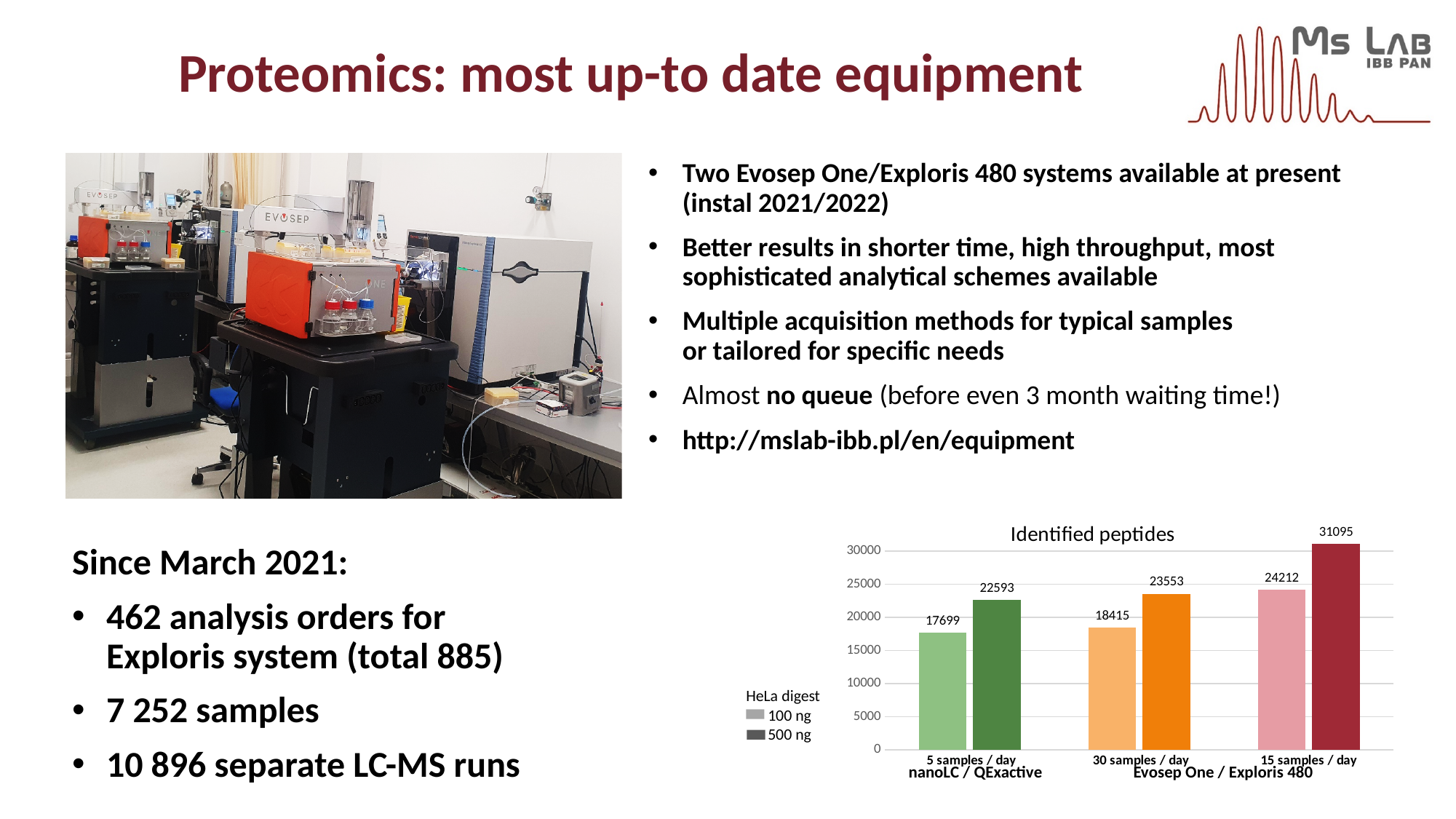
How many series does the chart legend list? 2 What type of chart is shown on the slide? bar chart How many identified peptides are shown for 500 ng at 15 samples / day? 31095 How many categories are shown on the x axis of the chart? 3 How many identified peptides are shown for 500 ng at 30 samples / day? 23553 What are the two legend entries in the chart? 100 ng and 500 ng Which is larger: the 100 ng value at 30 samples / day or the 100 ng value at 5 samples / day? 30 samples / day What is the difference between the 500 ng and 100 ng values at 15 samples / day? 6883 What is the title of the chart? Identified peptides How many identified peptides are shown for 100 ng at 5 samples / day? 17699 Which category has the lowest number of identified peptides for 100 ng? 5 samples / day Which category has the highest number of identified peptides for 500 ng? 15 samples / day